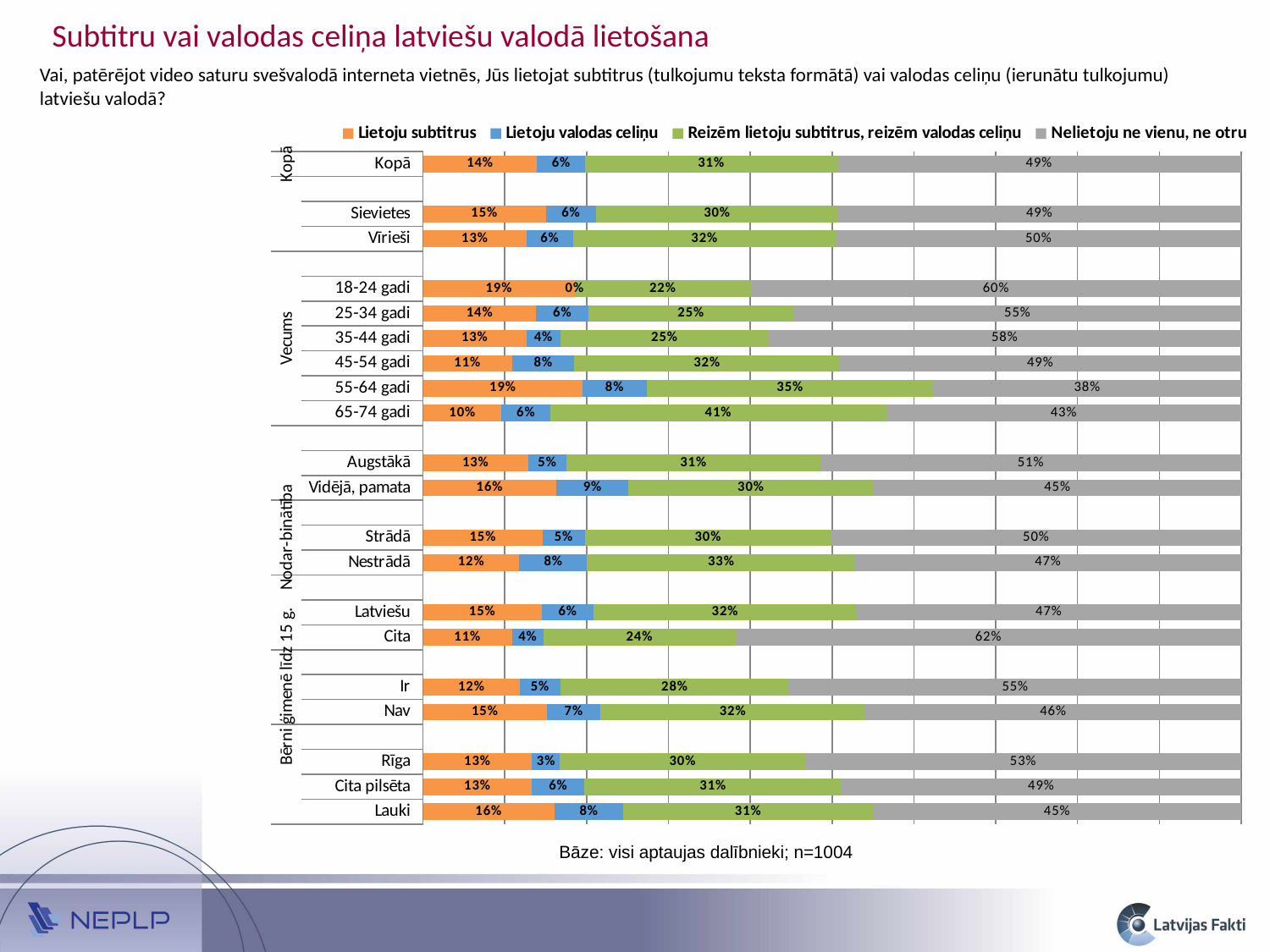
What is the value of "Nelietoju ne vienu, ne otru" for Kopā? 49% Which is larger: the "Lietoju subtitrus" value for Vidējā, pamata or for Augstākā? Vidējā, pamata What is the value of "Lietoju subtitrus" for Lauki? 16% What is the difference between the "Nelietoju ne vienu, ne otru" values for Cita and Latviešu? 15 percentage points Which category has the lowest value for "Nelietoju ne vienu, ne otru"? 55-64 gadi What is the total of the stacked bar for Kopā? 100% What is the value of "Reizēm lietoju subtitrus, reizēm valodas celiņu" for 65-74 gadi? 41% Which category has the highest value for "Nelietoju ne vienu, ne otru"? Cita What kind of chart is shown on the slide? Stacked bar chart How many series does the legend list? 4 What is the value of "Lietoju valodas celiņu" for 18-24 gadi? 0% Which category has the highest value for "Reizēm lietoju subtitrus, reizēm valodas celiņu"? 65-74 gadi